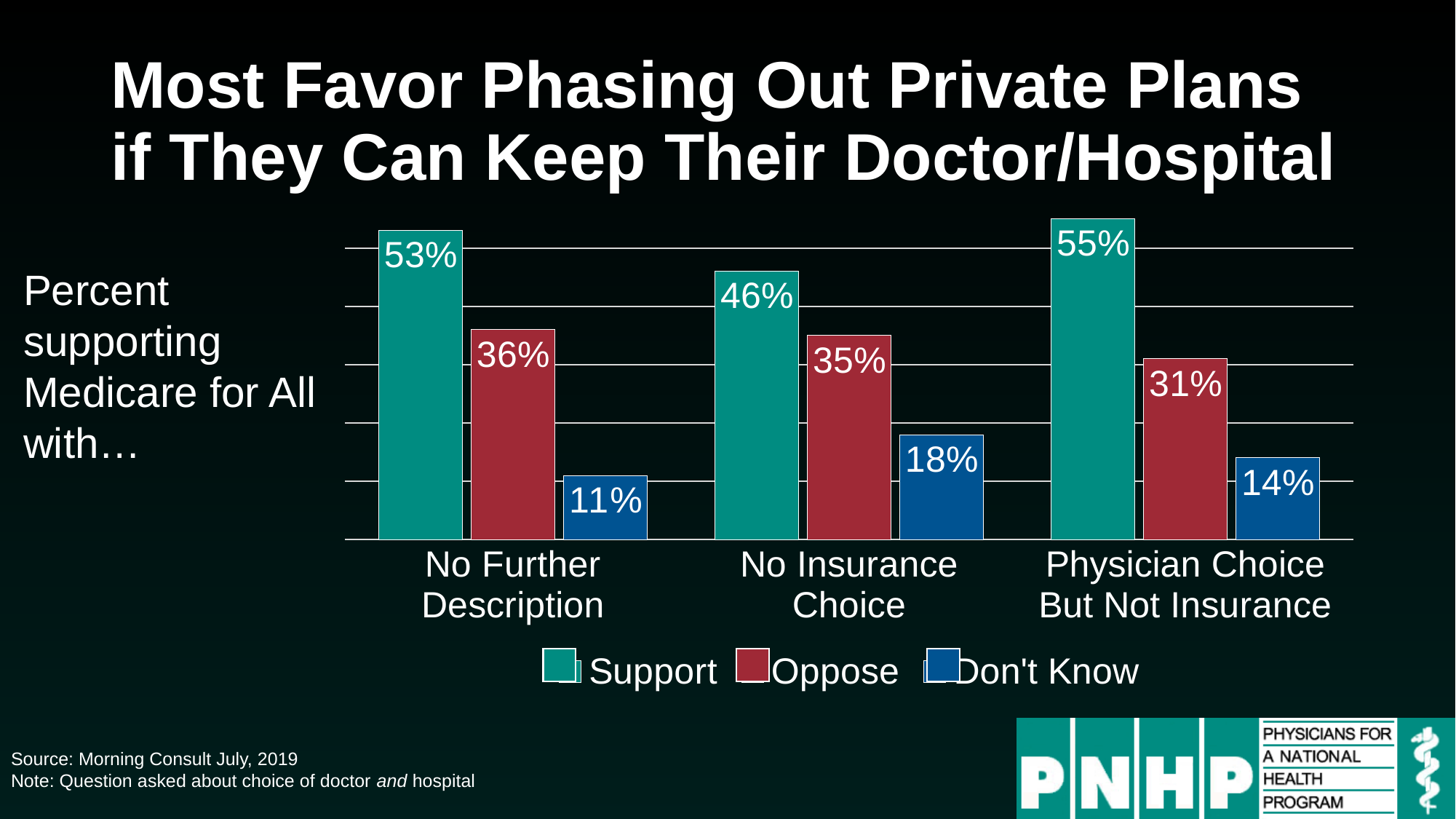
What is the difference between the Don't Know values for No Insurance Choice and Physician Choice But Not Insurance? 4% How many series does the legend list? 3 What colour are the Oppose bars? Red What is the Don't Know value for No Further Description? 11% Which is larger, the Oppose value for No Further Description or the Oppose value for Physician Choice But Not Insurance? No Further Description Which category has the highest Support value? Physician Choice But Not Insurance Which category has the lowest Don't Know value? No Further Description What kind of chart is shown on the slide? Bar chart What is the difference between the Support and Oppose values for No Further Description? 17% How many categories are shown on the x axis? 3 What is the Support value for No Insurance Choice? 46% What is the Oppose value for Physician Choice But Not Insurance? 31%